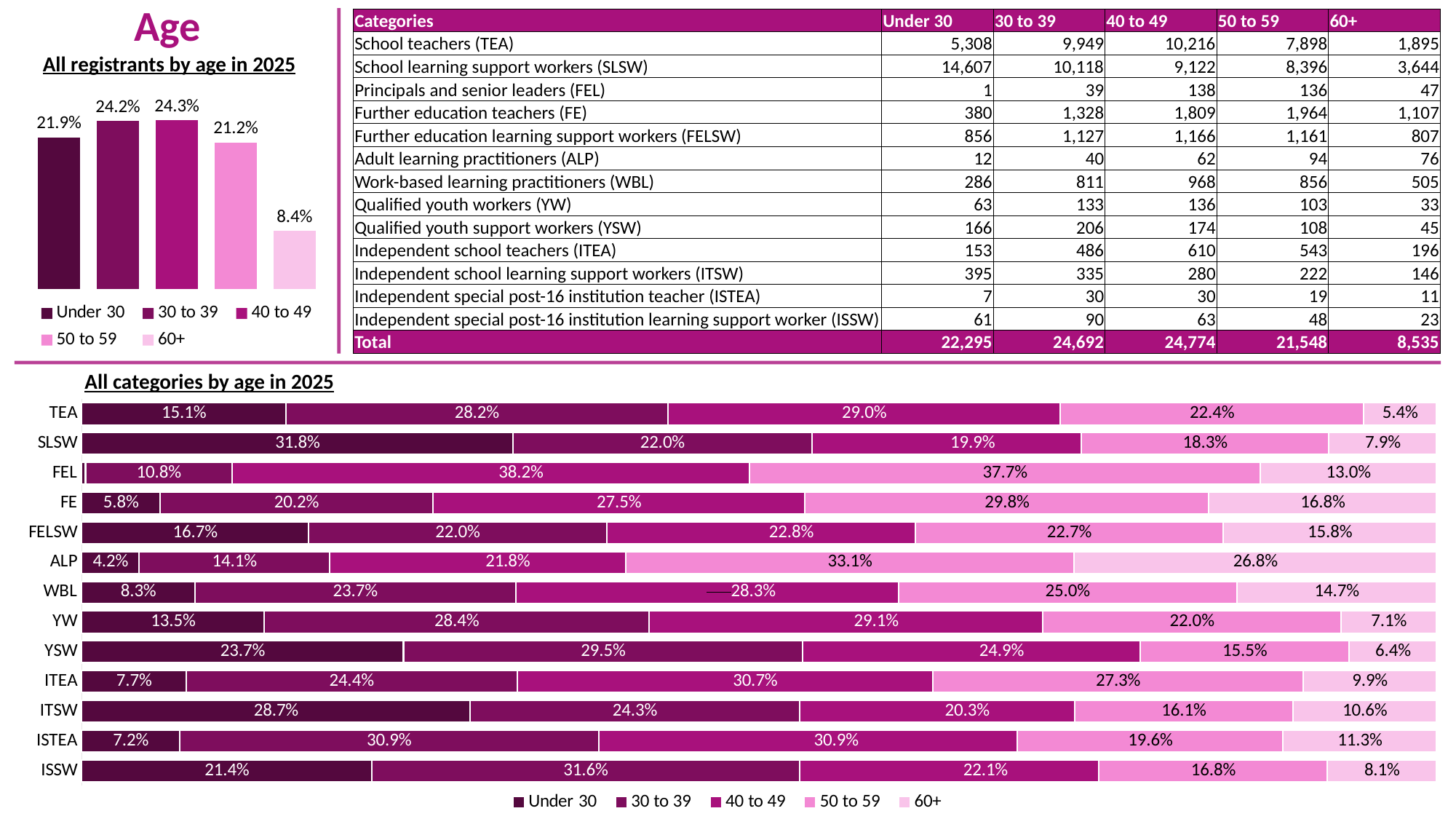
In the 'All categories by age in 2025' chart, what percentage of ALP registrants are aged 60+? 26.8% In the 'All categories by age in 2025' chart, what percentage of FEL registrants are aged 30 to 39? 10.8% How many series does the legend of the 'All categories by age in 2025' chart list? 5 In the 'All categories by age in 2025' chart, what is the difference between the 40 to 49 share and the Under 30 share for TEA? 13.9 percentage points In the 'All registrants by age in 2025' chart, what percentage of registrants are aged 30 to 39? 24.2% In the 'All categories by age in 2025' chart, which has the larger Under 30 share, TEA or SLSW? SLSW In the 'All registrants by age in 2025' chart, what is the difference between the Under 30 share and the 60+ share? 13.5 percentage points In the 'All registrants by age in 2025' chart, how many age groups are plotted? 5 What kind of chart is 'All categories by age in 2025'? Stacked bar chart In the 'All registrants by age in 2025' chart, which age group has the lowest share? 60+ In the 'All categories by age in 2025' chart, how many categories are shown? 13 In the 'All categories by age in 2025' chart, what percentage of SLSW registrants are Under 30? 31.8%